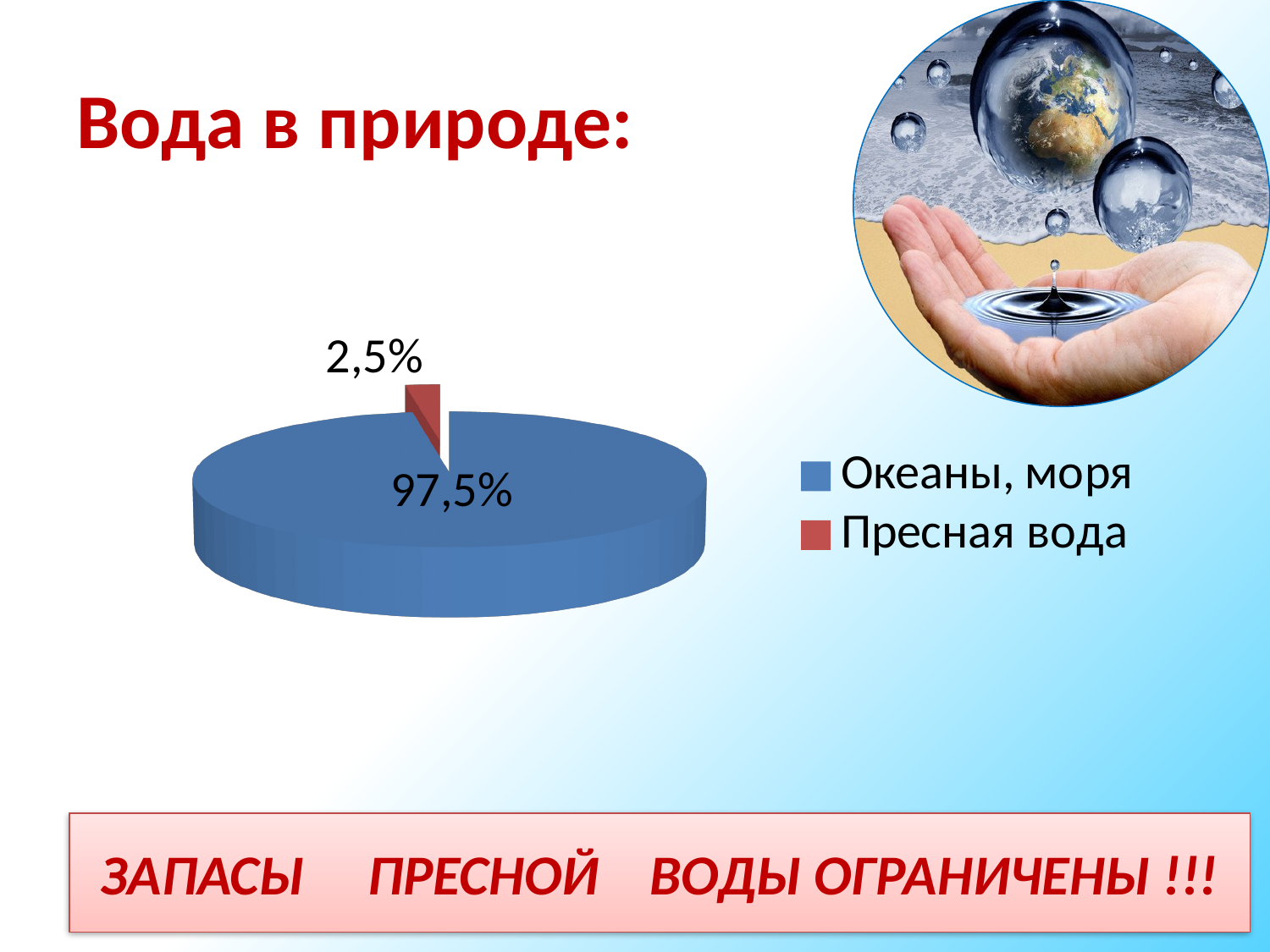
Which is larger: the share of "Океаны, моря" or the share of "Пресная вода"? Океаны, моря What is the difference between the shares of "Океаны, моря" and "Пресная вода"? 95% What share of the pie does "Пресная вода" represent? 2,5% What share of the pie does "Океаны, моря" represent? 97,5% What colour is the slice for "Пресная вода"? red Which slice of the pie is the smallest? Пресная вода What colour is the slice for "Океаны, моря"? blue How many entries does the legend list? 2 Which slice of the pie is the largest? Океаны, моря What kind of chart is shown on the slide? pie chart How many slices does the pie chart have? 2